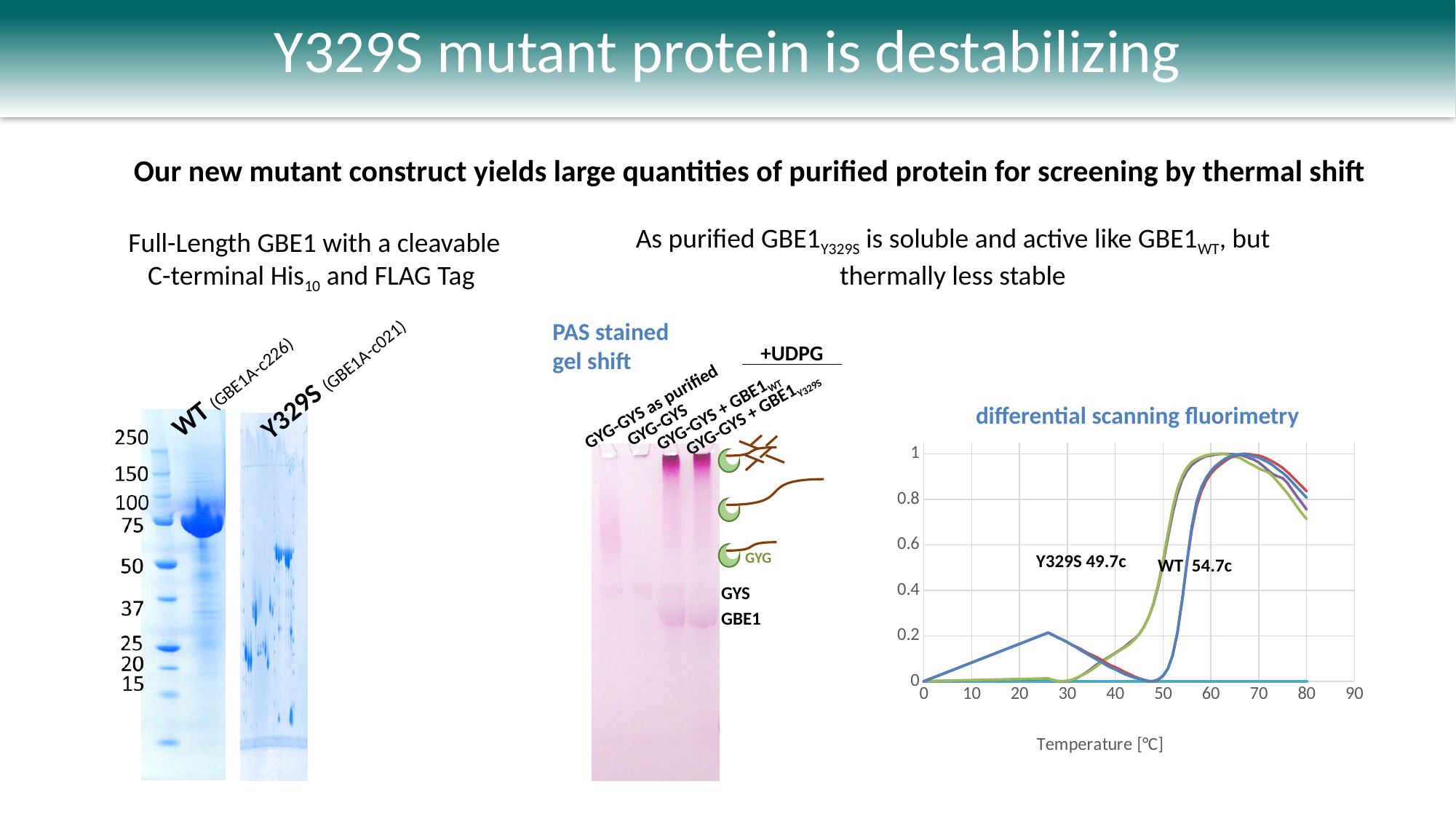
In the differential scanning fluorimetry chart, which has the higher annotated temperature, WT or Y329S? WT In the differential scanning fluorimetry chart, are the curve values at 80 on the x axis greater or less than 0.6? greater What kind of chart is the differential scanning fluorimetry chart? line chart In the differential scanning fluorimetry chart, are the curve values at 40 on the x axis greater or less than 0.4? less What is the highest tick value shown on the x axis of the differential scanning fluorimetry chart? 90 In the differential scanning fluorimetry chart, what is the difference between the annotated WT and Y329S temperatures? 5.0c In the differential scanning fluorimetry chart, what temperature is annotated for Y329S? 49.7c In the differential scanning fluorimetry chart, what temperature is annotated for WT? 54.7c In the differential scanning fluorimetry chart, do the curves rise or fall between 70 and 80 on the x axis? fall In the differential scanning fluorimetry chart, do the curves rise or fall between 50 and 60 on the x axis? rise What is the x-axis label of the differential scanning fluorimetry chart? Temperature [°C]